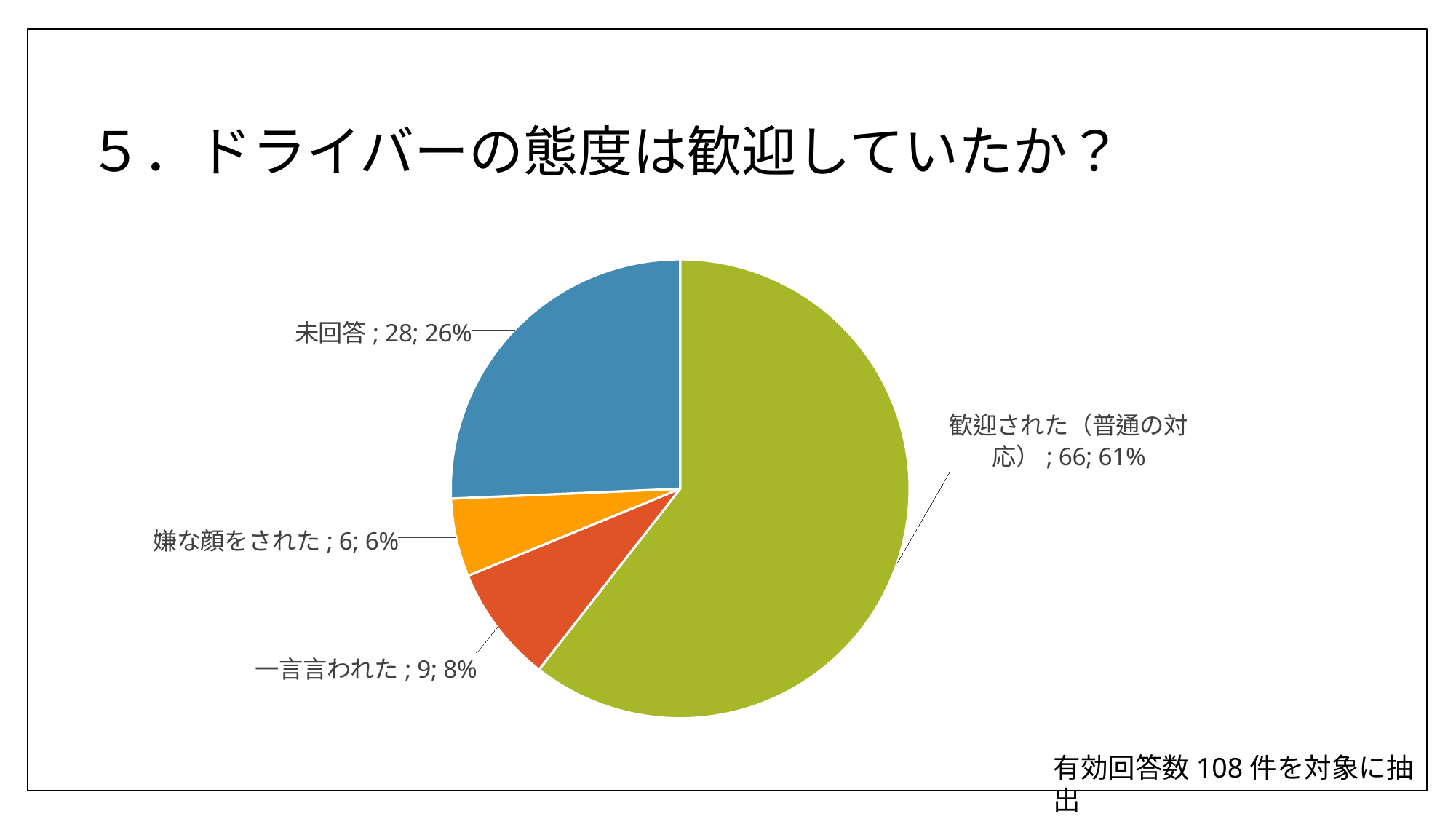
What is the count for 歓迎された（普通の対応）? 66 Which category has the largest slice? 歓迎された（普通の対応） What is the count for 一言言われた? 9 What is the count for 嫌な顔をされた? 6 What kind of chart is shown on the slide? pie chart How many slices does the pie chart have? 4 What is the difference between the counts for 歓迎された（普通の対応） and 未回答? 38 What is the count for 未回答? 28 What share of the pie does 未回答 represent? 26% What share of the pie does 歓迎された（普通の対応） represent? 61% Which category has the smallest slice? 嫌な顔をされた Which is larger, the count for 一言言われた or for 嫌な顔をされた? 一言言われた